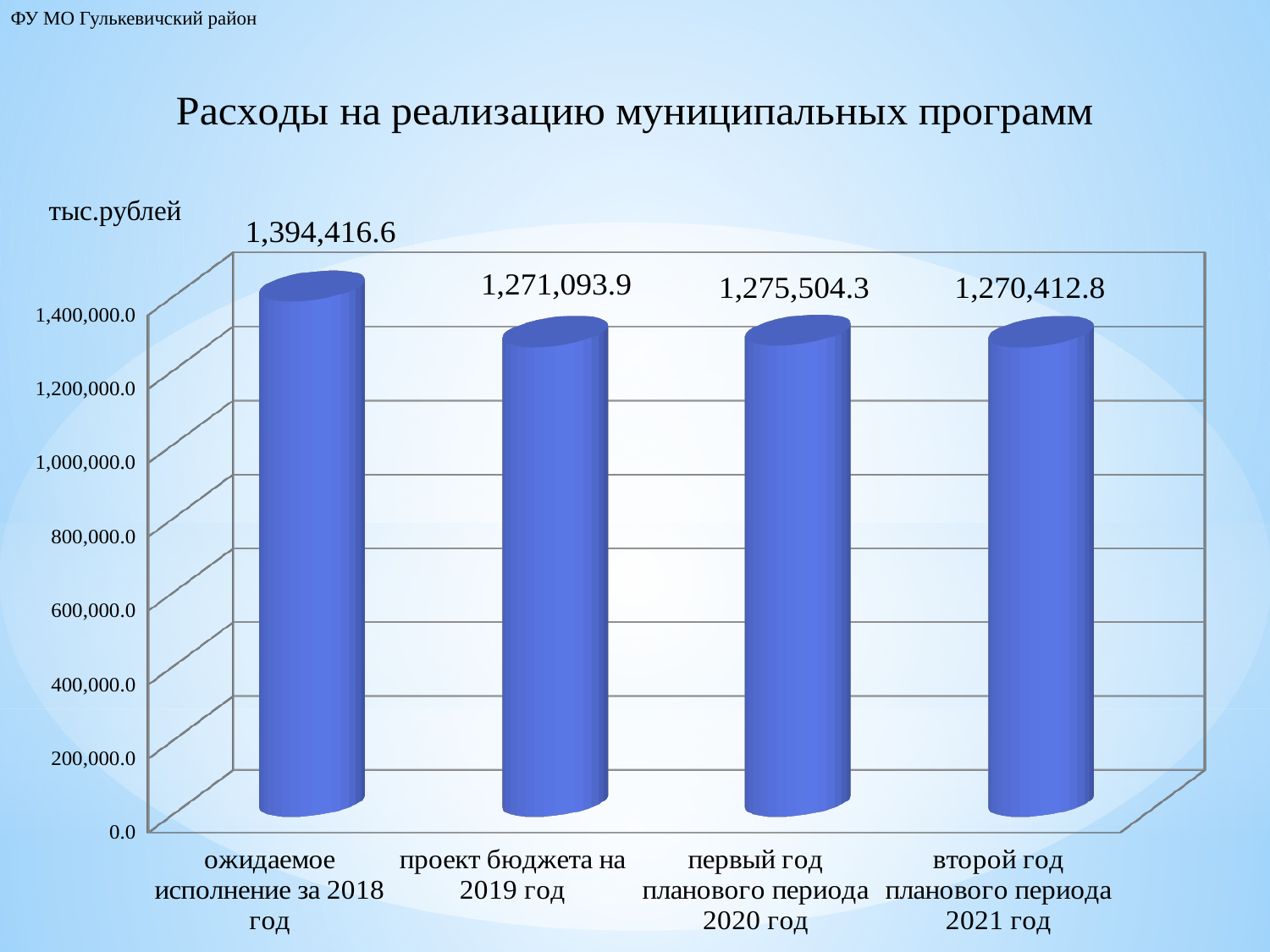
What is the value for 'второй год планового периода 2021 год'? 1,270,412.8 What kind of chart is shown on the slide? bar chart What is the difference between the value for 2018 and the value for 2019? 123,322.7 What is the value for 'ожидаемое исполнение за 2018 год'? 1,394,416.6 Is the value for 'проект бюджета на 2019 год' greater or less than 1,200,000.0? greater What is the value for 'проект бюджета на 2019 год'? 1,271,093.9 What is the value for 'первый год планового периода 2020 год'? 1,275,504.3 How many categories are shown on the chart? 4 What is the difference between the value for 2020 and the value for 2021? 5,091.5 Which category has the lowest value? второй год планового периода 2021 год Which category has the highest value? ожидаемое исполнение за 2018 год Which is larger: the value for 2019 or the value for 2020? 2020 (1,275,504.3)